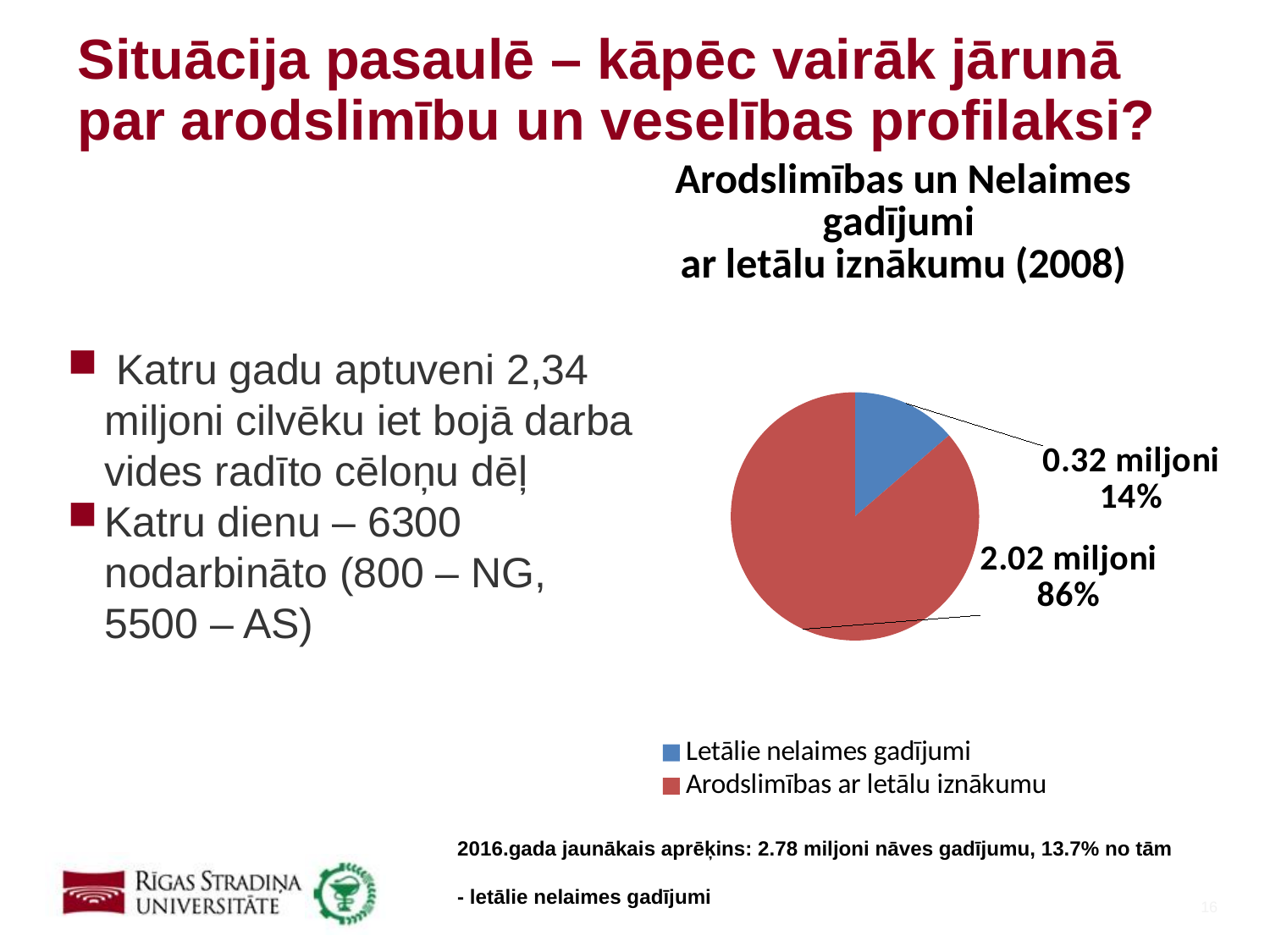
What share of the pie does Arodslimības ar letālu iznākumu represent? 86% What is the title of the chart? Arodslimības un Nelaimes gadījumi ar letālu iznākumu (2008) What kind of chart is shown on the slide? pie chart Which category has the largest slice of the pie? Arodslimības ar letālu iznākumu What value is shown for Arodslimības ar letālu iznākumu? 2.02 miljoni What value is shown for Letālie nelaimes gadījumi? 0.32 miljoni Which is larger, Arodslimības ar letālu iznākumu or Letālie nelaimes gadījumi? Arodslimības ar letālu iznākumu How many entries does the legend list? 2 How many slices does the pie chart have? 2 Which category has the smallest slice of the pie? Letālie nelaimes gadījumi What colour is the slice for Letālie nelaimes gadījumi? blue What share of the pie does Letālie nelaimes gadījumi represent? 14%